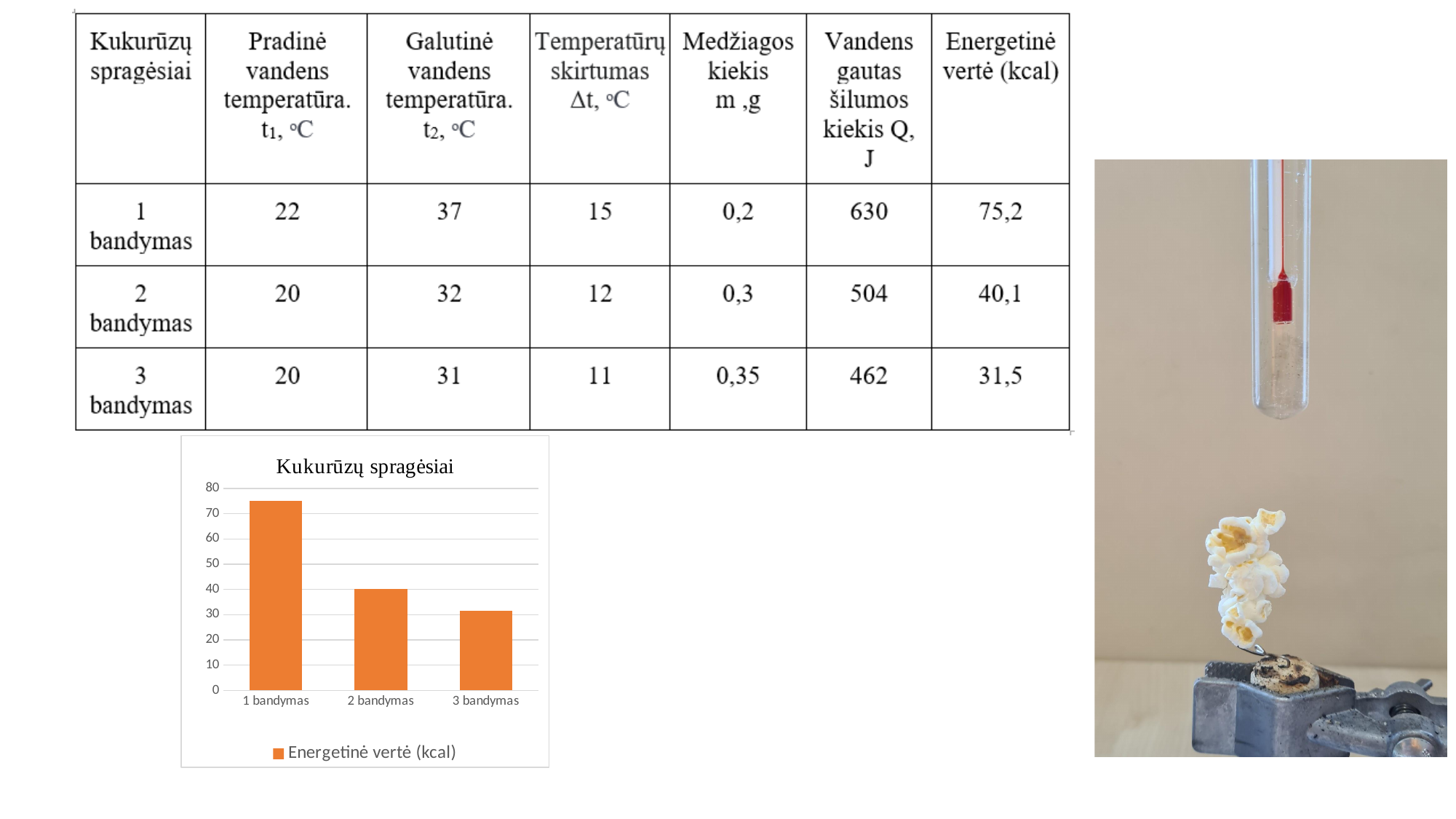
Do the values in the chart rise or fall from 1 bandymas to 3 bandymas? fall Which category has the lowest bar in the chart? 3 bandymas What type of chart is shown on the slide? bar chart Is the value for 1 bandymas in the chart greater or less than 70? greater What is the title of the chart? Kukurūzų spragėsiai What series name is shown in the chart legend? Energetinė vertė (kcal) Which category has the highest bar in the chart? 1 bandymas Is the value for 2 bandymas in the chart greater or less than 50? less Which is larger in the chart, the value for 2 bandymas or 3 bandymas? 2 bandymas How many categories are shown on the x axis of the chart? 3 Is the value for 3 bandymas in the chart greater or less than 30? greater How many series does the chart legend list? 1